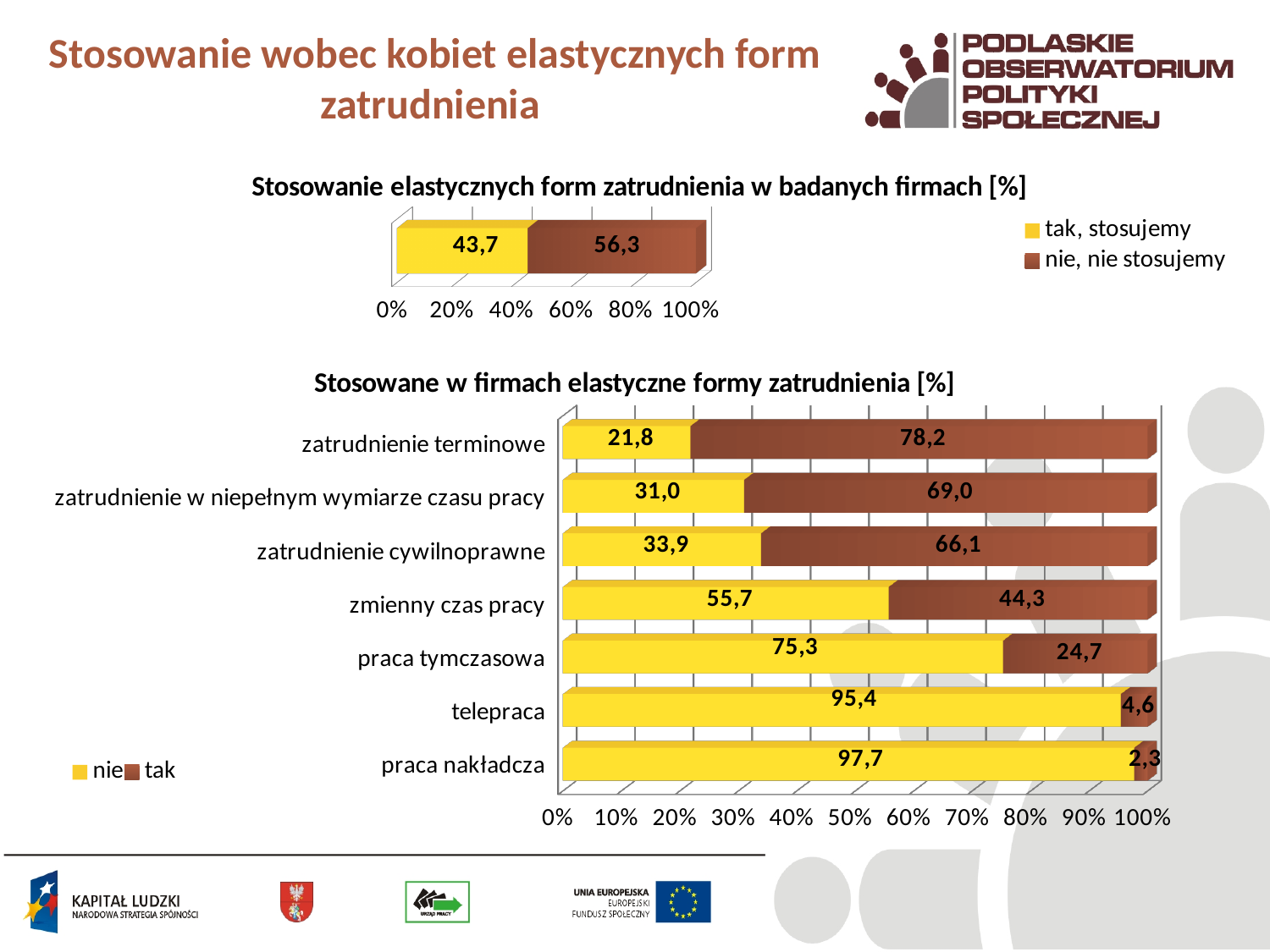
In the bottom chart, what is the difference between the 'nie' and 'tak' values for 'zmienny czas pracy'? 11,4 In the bottom chart, which colour represents the 'nie' series? yellow In the bottom chart 'Stosowane w firmach elastyczne formy zatrudnienia [%]', which category has the lowest 'tak' value? praca nakładcza In the bottom chart 'Stosowane w firmach elastyczne formy zatrudnienia [%]', what is the 'tak' value for 'zatrudnienie terminowe'? 78,2 In the top chart, which is larger: 'tak, stosujemy' or 'nie, nie stosujemy'? nie, nie stosujemy In the bottom chart, how many categories are shown? 7 In the bottom chart 'Stosowane w firmach elastyczne formy zatrudnienia [%]', which category has the highest 'tak' value? zatrudnienie terminowe In the top chart 'Stosowanie elastycznych form zatrudnienia w badanych firmach [%]', what is the value for 'tak, stosujemy'? 43,7 What kind of chart is the bottom chart 'Stosowane w firmach elastyczne formy zatrudnienia [%]'? stacked bar chart In the top chart 'Stosowanie elastycznych form zatrudnienia w badanych firmach [%]', what is the value for 'nie, nie stosujemy'? 56,3 In the bottom chart, how many series does the legend list? 2 In the bottom chart 'Stosowane w firmach elastyczne formy zatrudnienia [%]', what is the 'nie' value for 'telepraca'? 95,4